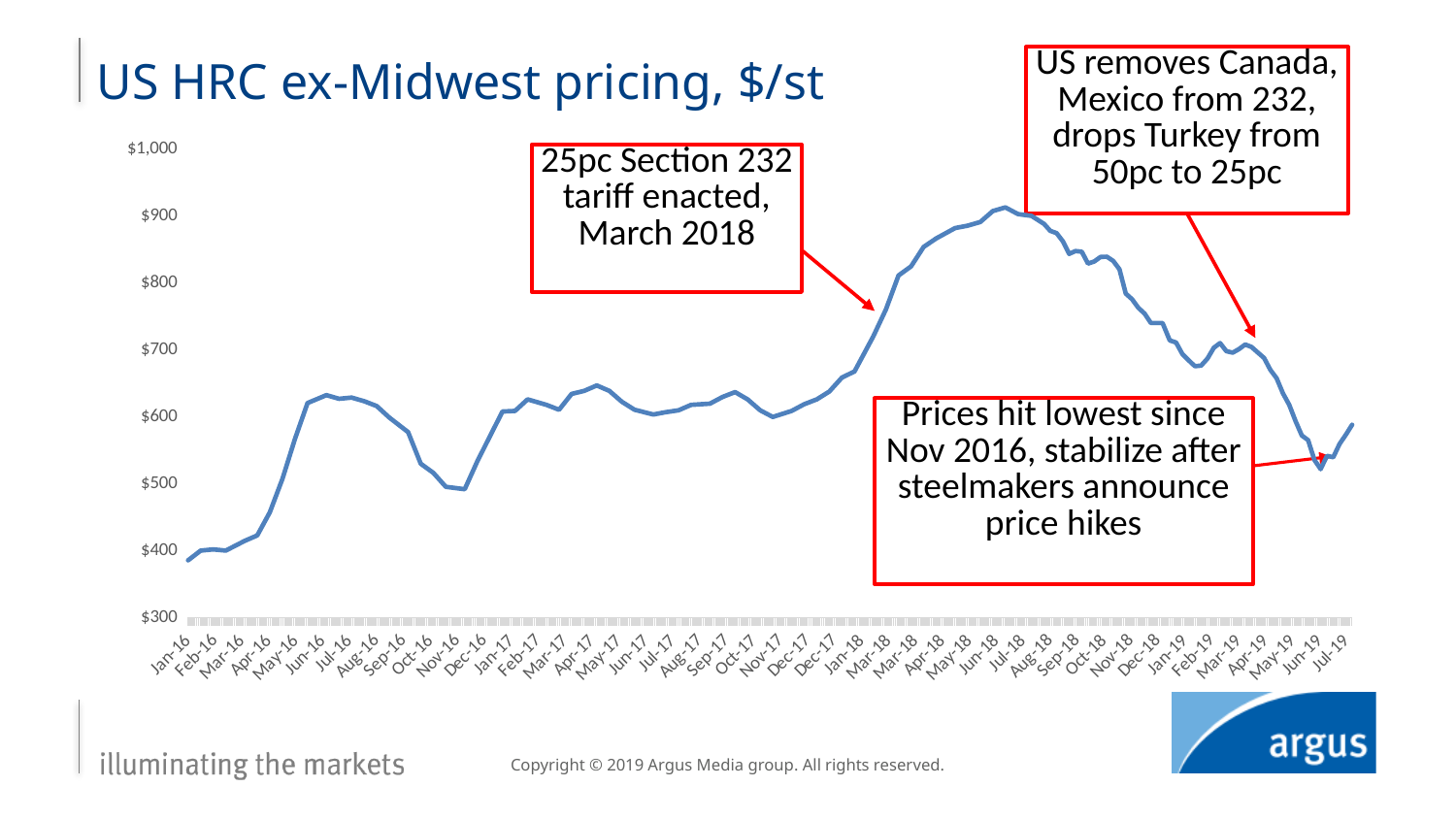
Is the value for Jun-19 greater or less than $500? greater Do prices rise or fall between Jan-16 and Jun-16? rise Is the value for Jun-16 greater or less than $600? greater According to the annotation, when was the 25pc Section 232 tariff enacted? March 2018 What kind of chart is shown on the slide? line chart Around which month does the price reach its highest point? Jul-18 What is the title of the chart? US HRC ex-Midwest pricing, $/st Do prices rise or fall between Jul-18 and Jun-19? fall Is the value for Jul-18 greater or less than $900? greater